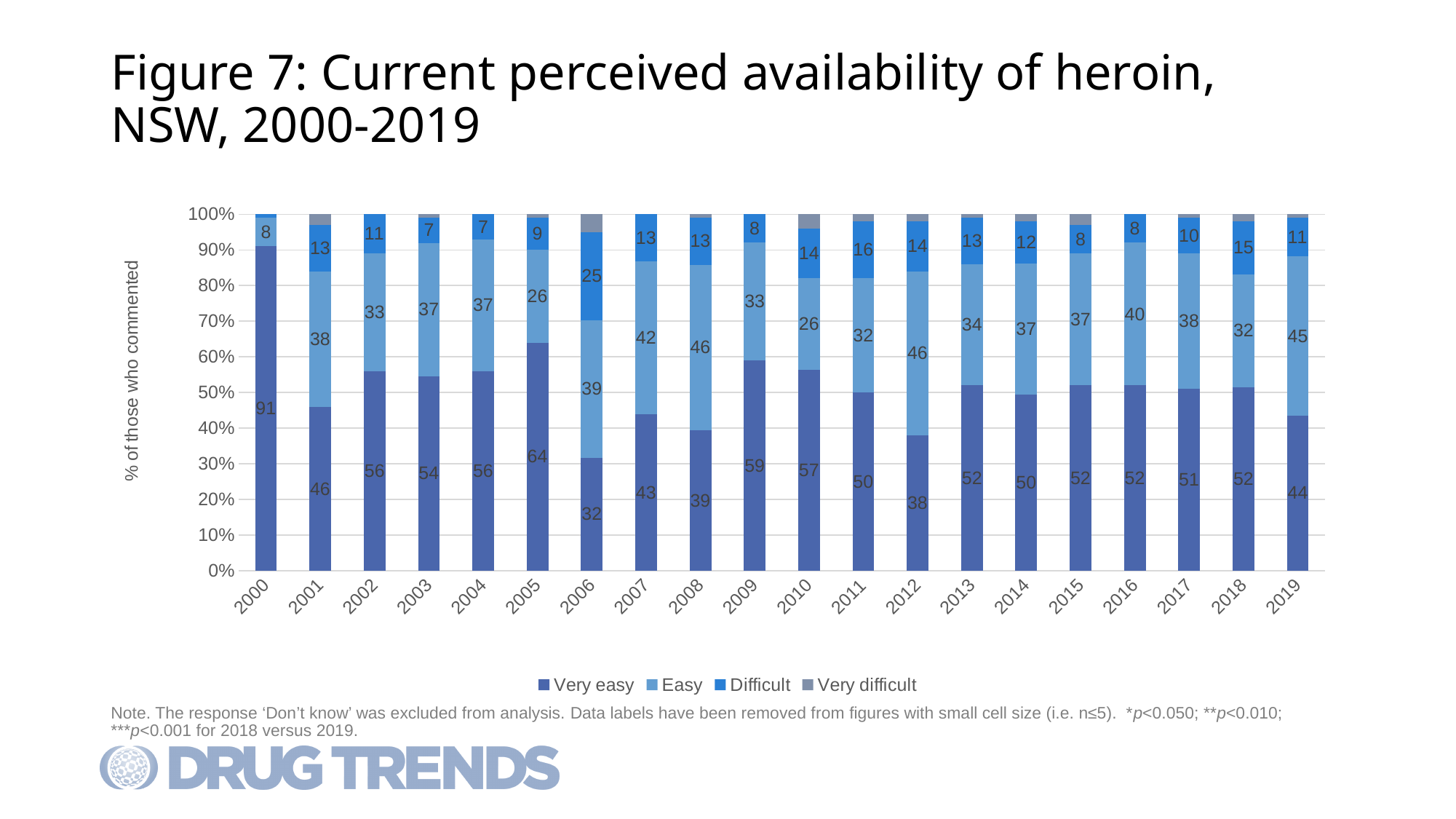
What is the 'Easy' value for 2016? 40 How many series does the legend list? 4 How many years are shown along the x axis of the chart? 20 In which year is the 'Difficult' value highest? 2006 What is the label on the y axis of the chart? % of those who commented In which year is the 'Very easy' value lowest? 2006 What is the 'Very easy' value for 2000? 91 In which year is the 'Very easy' value highest? 2000 What kind of chart is shown on the slide? Stacked bar chart What is the 'Difficult' value for 2006? 25 What is the difference between the 'Very easy' values for 2018 and 2019? 8 Which is larger, the 'Easy' value for 2008 or the 'Easy' value for 2010? 2008